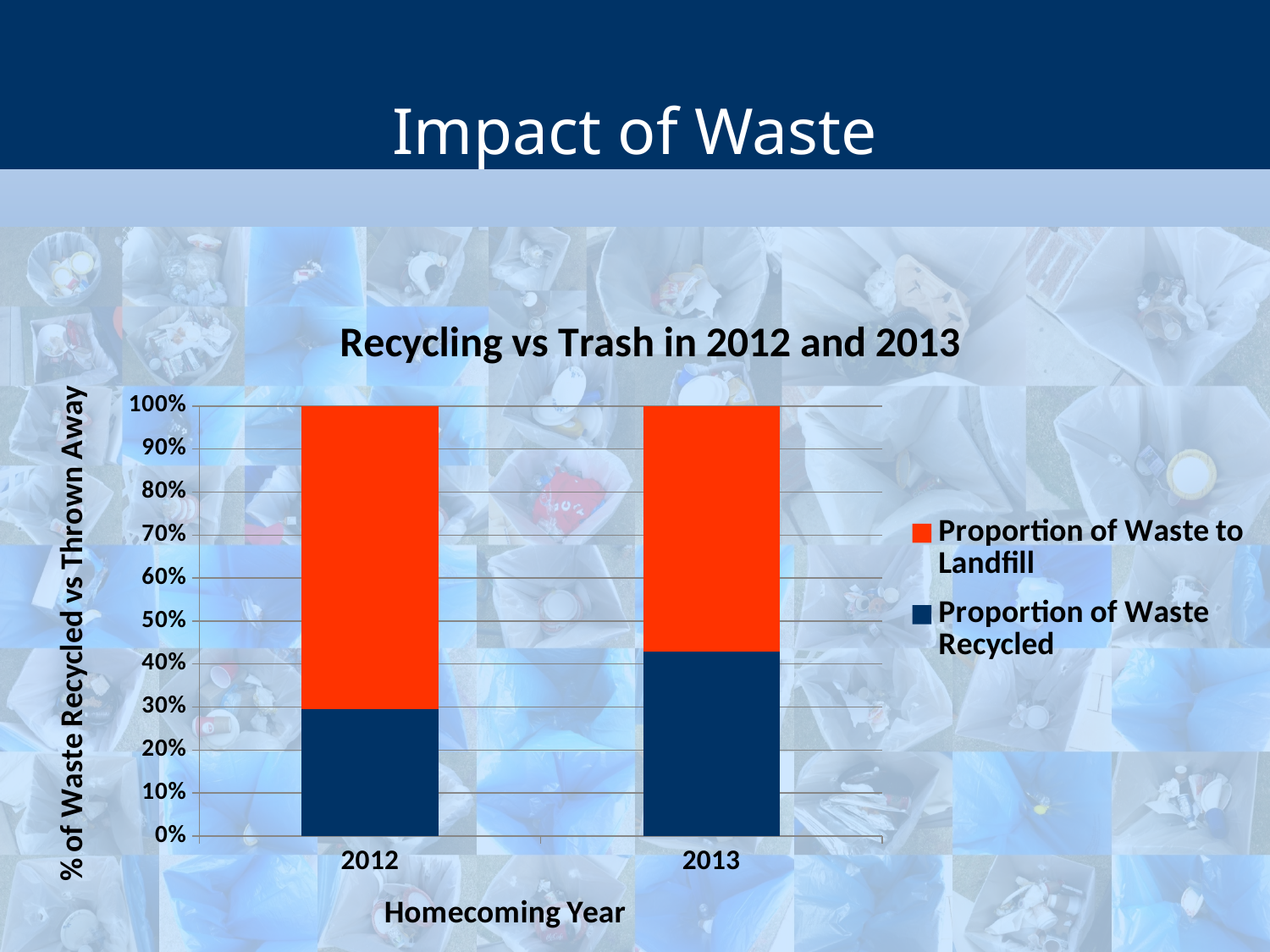
What is the total of the stacked bar for 2012? 100% In 2012, which is larger: the Proportion of Waste to Landfill or the Proportion of Waste Recycled? Proportion of Waste to Landfill Does the Proportion of Waste Recycled rise or fall from 2012 to 2013? rise Is the Proportion of Waste to Landfill in 2012 greater or less than 60%? greater How many years (categories) are shown on the x axis? 2 Which year has the lower Proportion of Waste to Landfill? 2013 What type of chart is shown on the slide? stacked bar chart Is the Proportion of Waste Recycled in 2012 greater or less than 40%? less Which year has the higher Proportion of Waste Recycled? 2013 What is the title of the chart? Recycling vs Trash in 2012 and 2013 How many series does the legend list? 2 Is the Proportion of Waste Recycled in 2013 greater or less than 40%? greater